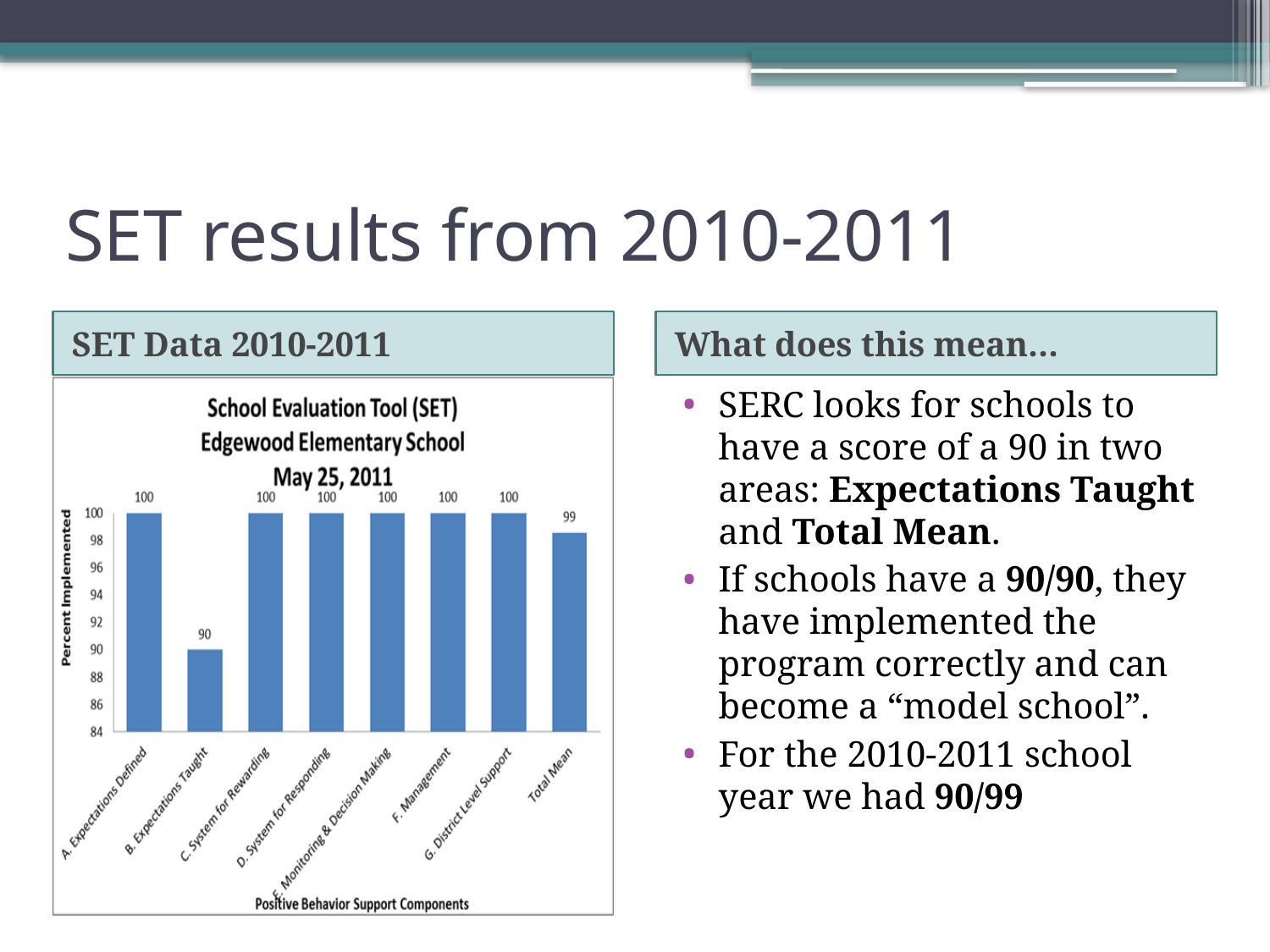
What is the label of the x axis? Positive Behavior Support Components Is the value for B. Expectations Taught greater or less than 92? less What kind of chart is shown on the slide? Bar chart Which category has the lowest value? B. Expectations Taught What is the label of the y axis? Percent Implemented What is the value for Total Mean? 99 What is the value for B. Expectations Taught? 90 What is the difference between the value for A. Expectations Defined and the value for B. Expectations Taught? 10 What is the difference between the value for Total Mean and the value for B. Expectations Taught? 9 How many categories are shown on the x axis? 8 What is the value for F. Management? 100 Which is larger, the value for G. District Level Support or the value for Total Mean? G. District Level Support